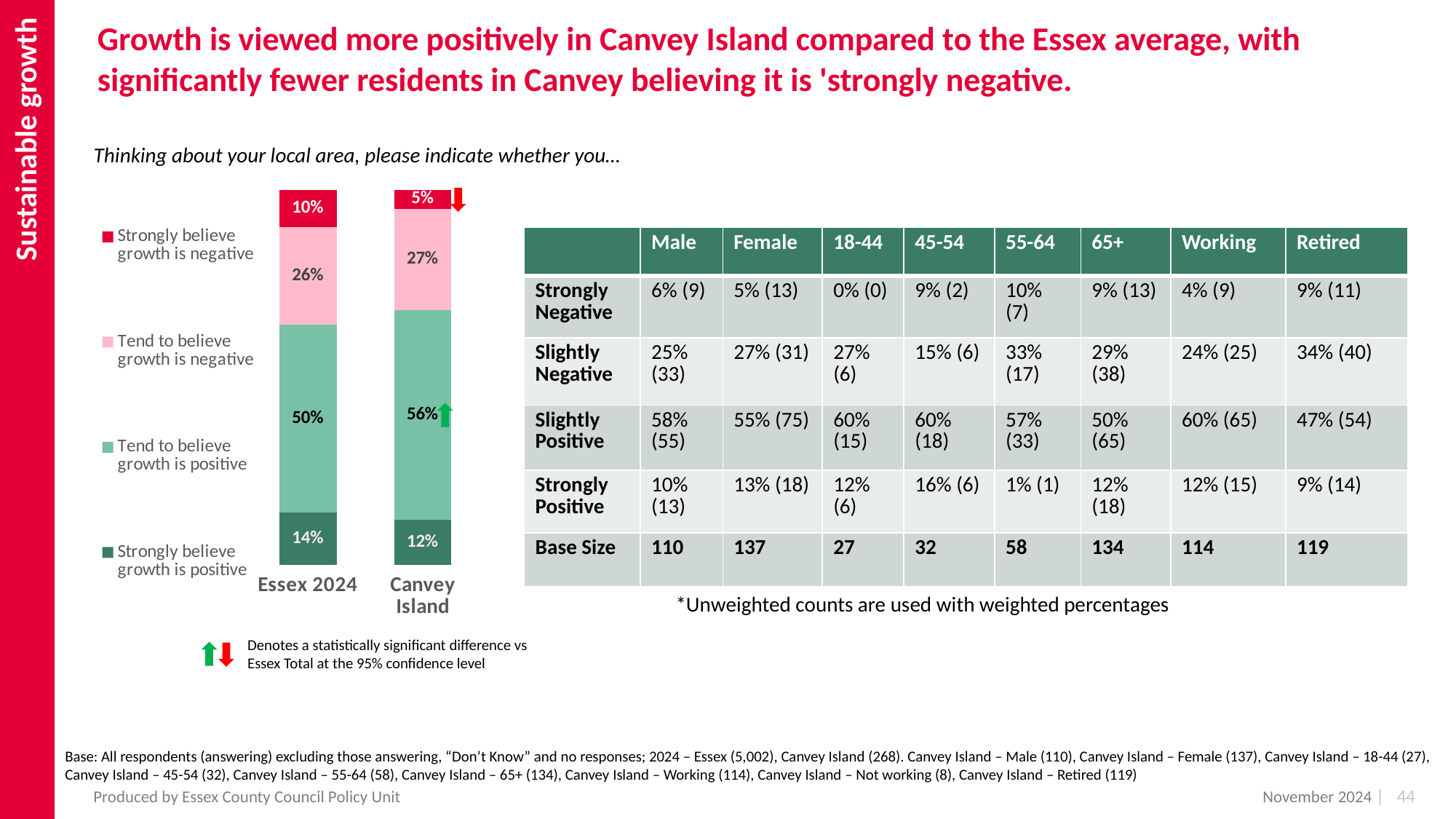
How many bars (categories) are shown in the chart? 2 What percentage of Canvey Island respondents strongly believe growth is negative? 5% Which of the two bars has the larger share of respondents who tend to believe growth is positive, Essex 2024 or Canvey Island? Canvey Island What percentage of Essex 2024 respondents strongly believe growth is positive? 14% Which segment is the largest in the Canvey Island bar? Tend to believe growth is positive How many series does the chart legend list? 4 Which segment is the smallest in the Canvey Island bar? Strongly believe growth is negative What percentage of Essex 2024 respondents tend to believe growth is positive? 50% What percentage of Canvey Island respondents tend to believe growth is negative? 27% What is the difference between the Essex 2024 and Canvey Island percentages for 'Strongly believe growth is negative'? 5 percentage points What is the difference between the Canvey Island and Essex 2024 percentages for 'Tend to believe growth is positive'? 6 percentage points What type of chart is shown on the slide? Stacked bar chart